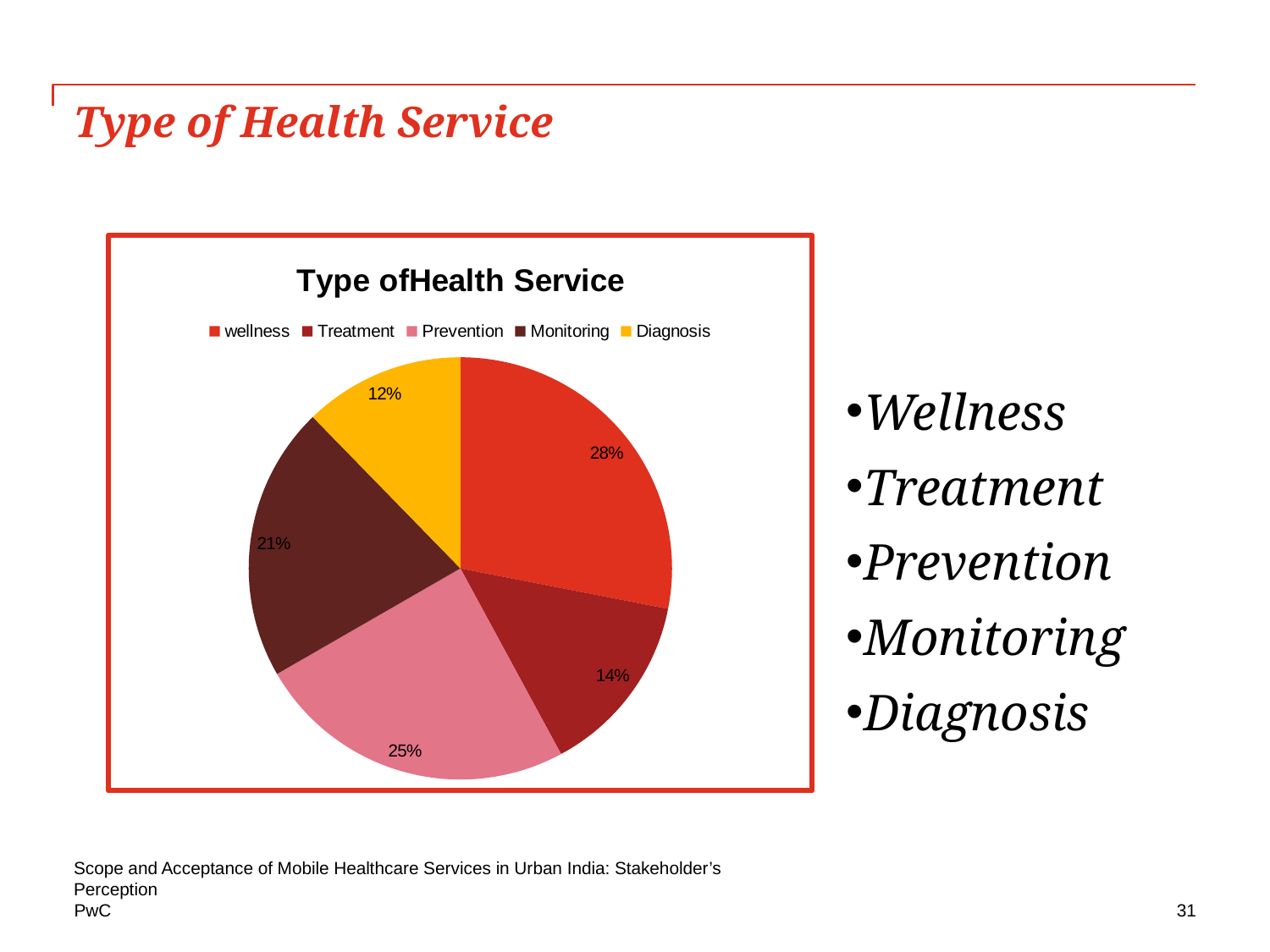
What is the difference between the shares for Prevention and Treatment? 11% What type of chart is shown on the slide? Pie chart What is the title of the chart? Type ofHealth Service What is the value for Monitoring? 21% What share of the pie does wellness represent? 28% Which category has the largest share of the pie? wellness What is the value for Prevention? 25% What is the value for Treatment? 14% Which category has the smallest share of the pie? Diagnosis What is the value for Diagnosis? 12% How many series does the legend list? 5 How many slices does the pie chart have? 5